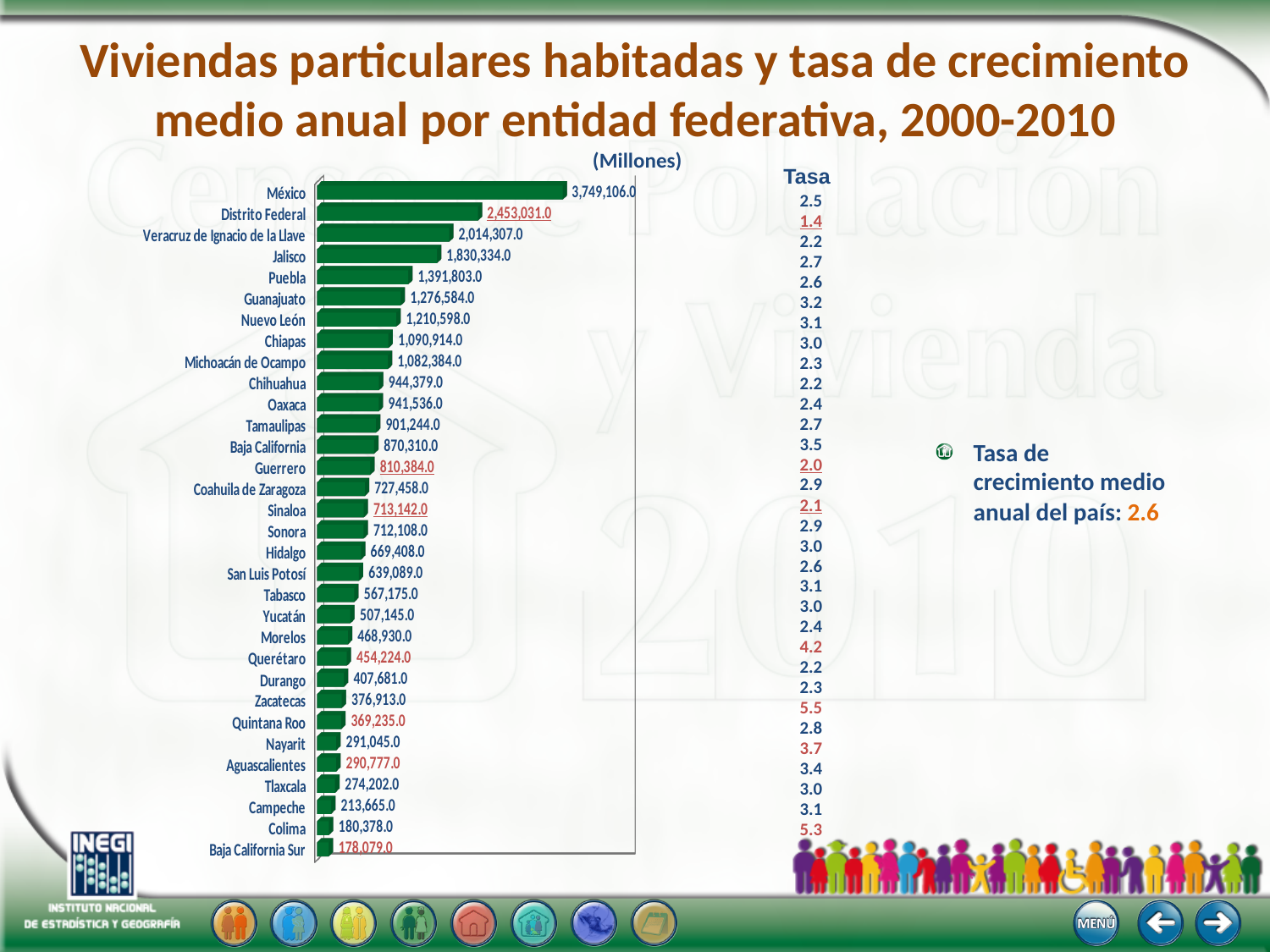
What is the difference between the values for México and Distrito Federal? 1,296,075.0 How many entities (bars) are shown in the chart? 32 Which has a larger value, Chihuahua or Oaxaca? Chihuahua What is the value shown for Quintana Roo? 369,235.0 What is the value shown for México? 3,749,106.0 What is the difference between the values for Jalisco and Puebla? 438,531.0 Which entity has the highest value in the chart? México Do the bar values increase or decrease from the top of the chart to the bottom? Decrease Which entity has the lowest value in the chart? Baja California Sur Which has a larger value, Nayarit or Aguascalientes? Nayarit What is the value shown for Guerrero? 810,384.0 What kind of chart is shown on the slide? Bar chart